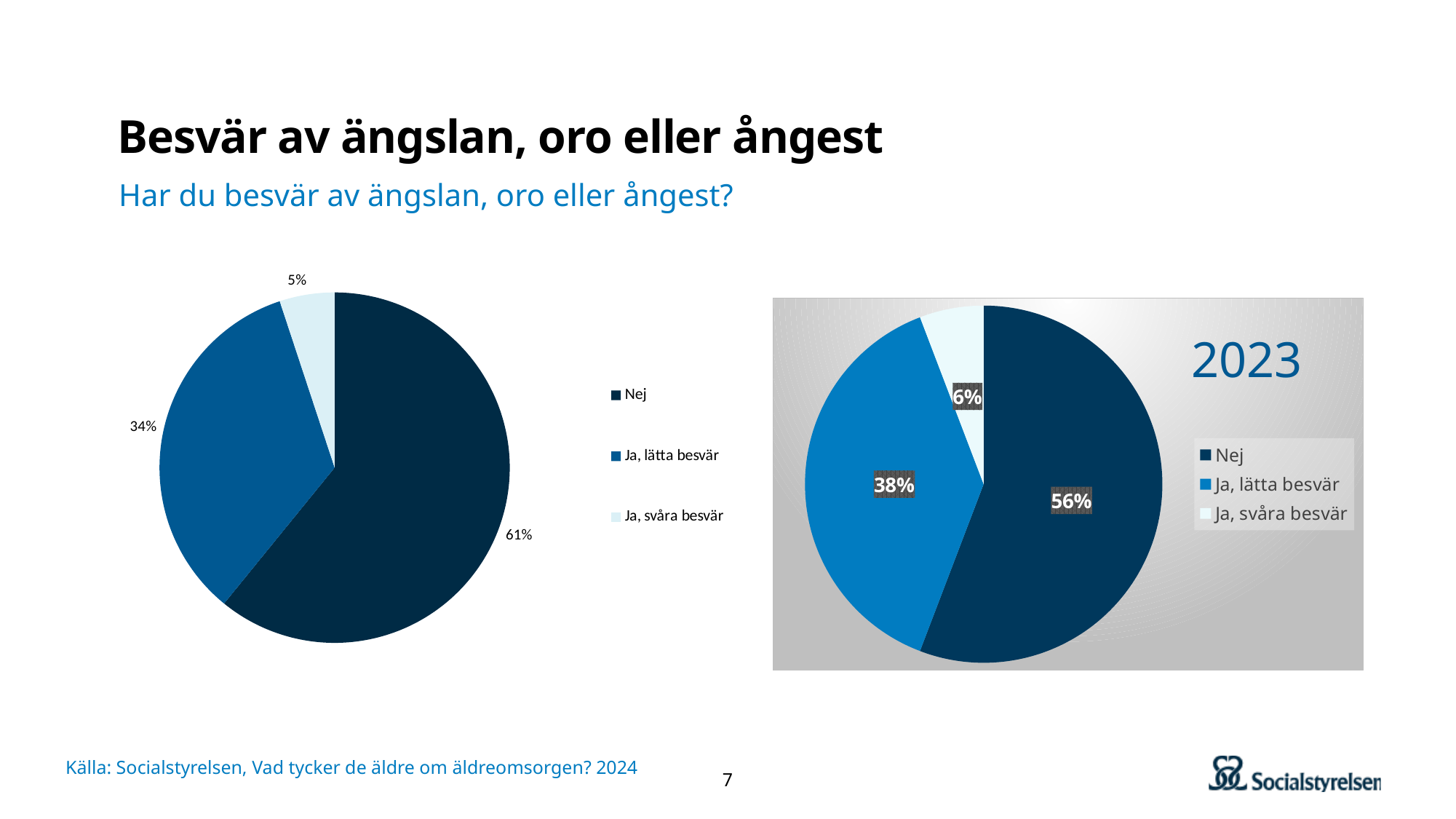
What type of chart is shown on the right side of the slide? Pie chart In the left pie chart, what share is shown for Ja, lätta besvär? 34% What is the difference between the Nej share in the left pie chart and the Nej share in the right pie chart labelled 2023? 5 percentage points In the left pie chart, what share is shown for Ja, svåra besvär? 5% In the right pie chart labelled 2023, what share is shown for Ja, lätta besvär? 38% In the right pie chart labelled 2023, what share is shown for Ja, svåra besvär? 6% In the left pie chart, what share is shown for Nej? 61% Is the share for Ja, lätta besvär larger in the left pie chart or in the right pie chart labelled 2023? Right pie chart (2023) How many categories does the legend of the left pie chart list? 3 In the left pie chart, which category has the largest slice? Nej In the right pie chart labelled 2023, what share is shown for Nej? 56% In the right pie chart labelled 2023, which category has the smallest slice? Ja, svåra besvär